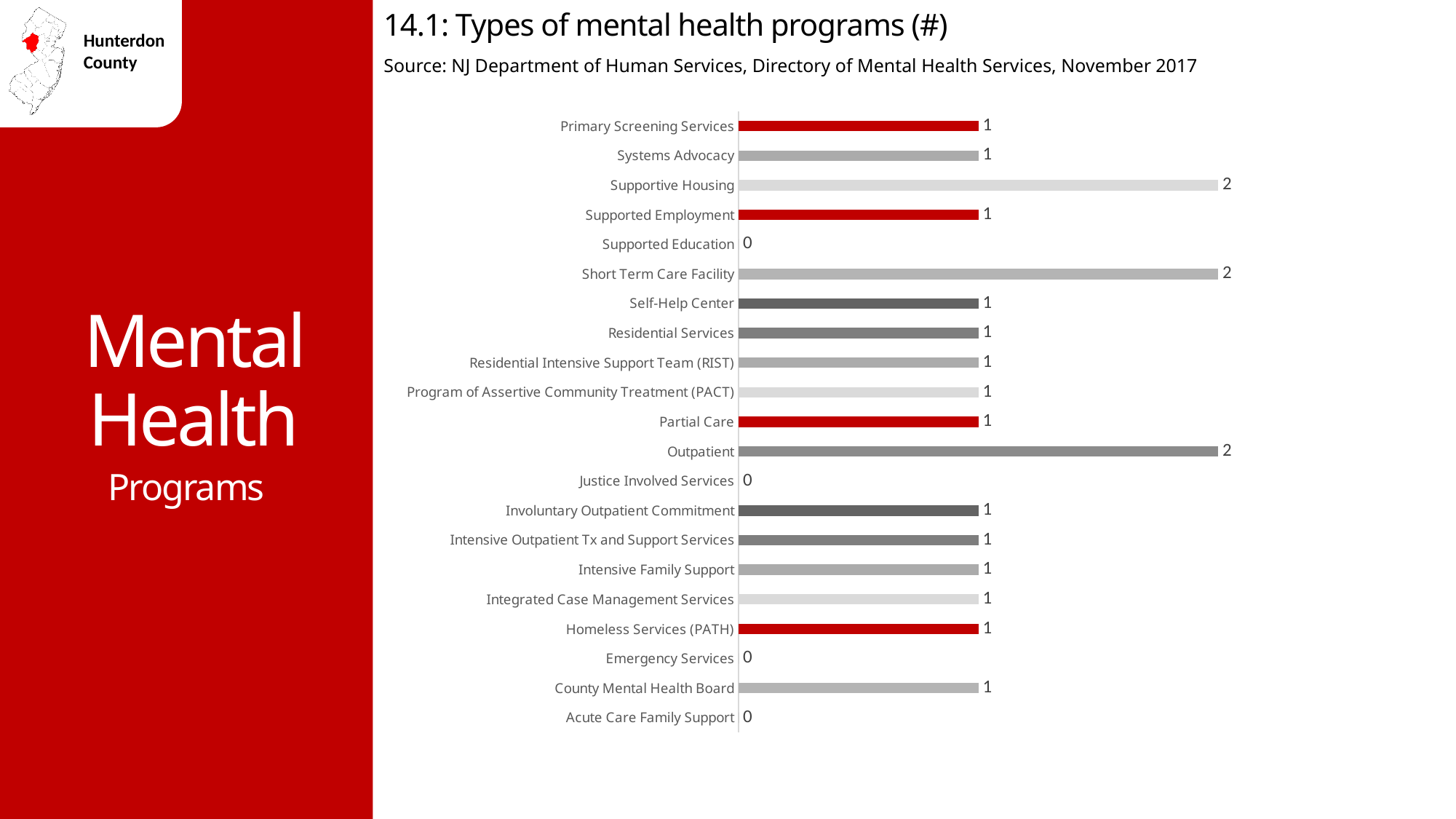
What is the value for Outpatient? 2 How many types of mental health programs are listed in the chart? 21 Which is larger, the value for Supportive Housing or the value for Systems Advocacy? Supportive Housing What is the value for Supported Education? 0 What type of chart is shown on the slide? Bar chart What is the difference between the value for Outpatient and the value for Partial Care? 1 How many program types have a value of 2? 3 What is the title of the chart? 14.1: Types of mental health programs (#) What is the value for Homeless Services (PATH)? 1 How many program types have a value of 0? 4 Which is larger, the value for Emergency Services or the value for County Mental Health Board? County Mental Health Board What is the value for Short Term Care Facility? 2